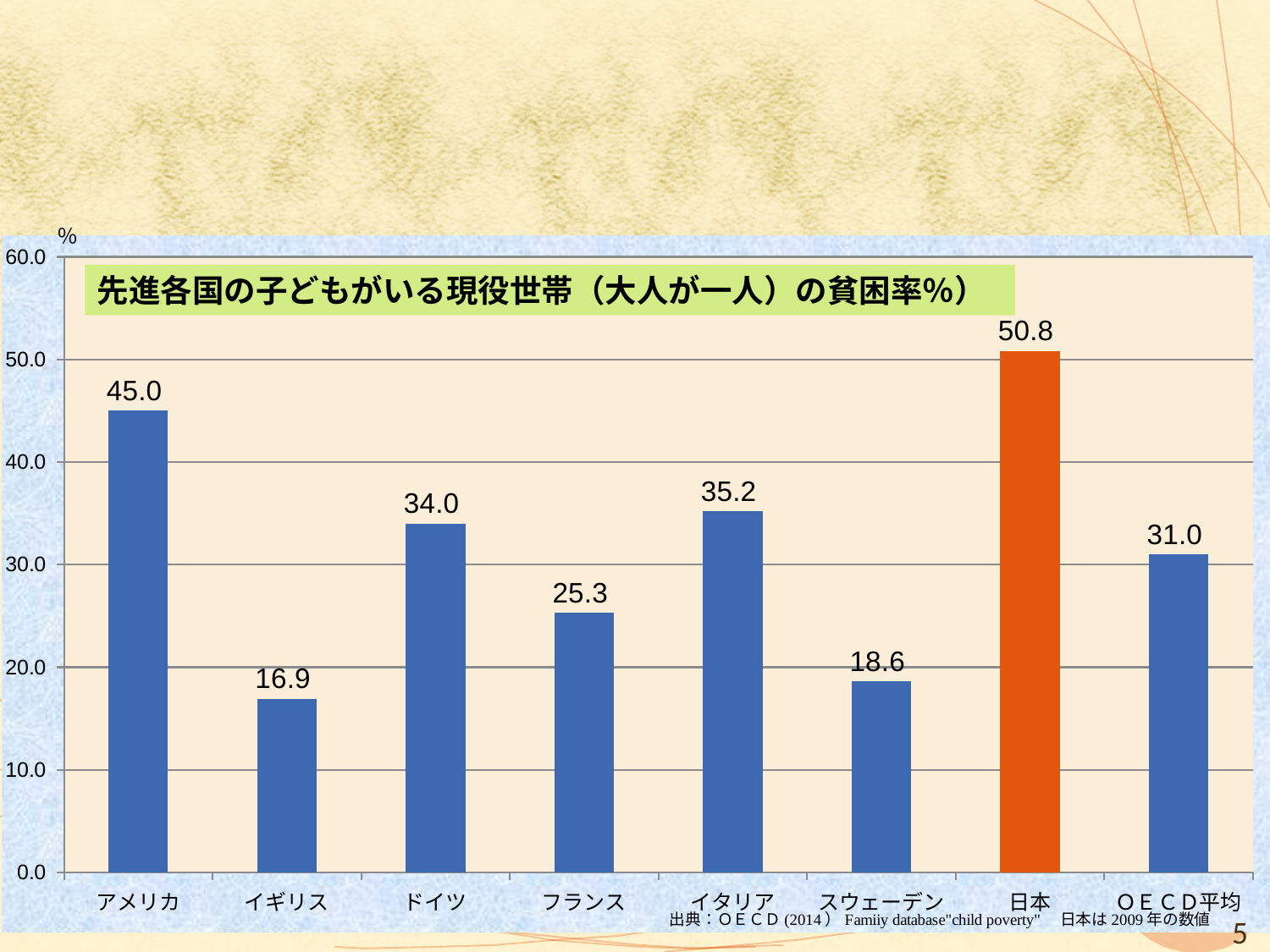
What is the value for アメリカ (USA)? 45.0 What is the value for 日本 (Japan)? 50.8 What is the value for OECD平均 (OECD average)? 31.0 What is the difference between the values for 日本 and OECD平均? 19.8 What kind of chart is shown on the slide? bar chart What is the value for スウェーデン (Sweden)? 18.6 Which category has the highest value? 日本 Which category has the lowest value? イギリス How many categories are shown on the x axis? 8 What is the difference between the values for イタリア and ドイツ? 1.2 Which is larger, the value for フランス or the value for ドイツ? ドイツ Which bar is coloured differently (orange) from the others? 日本